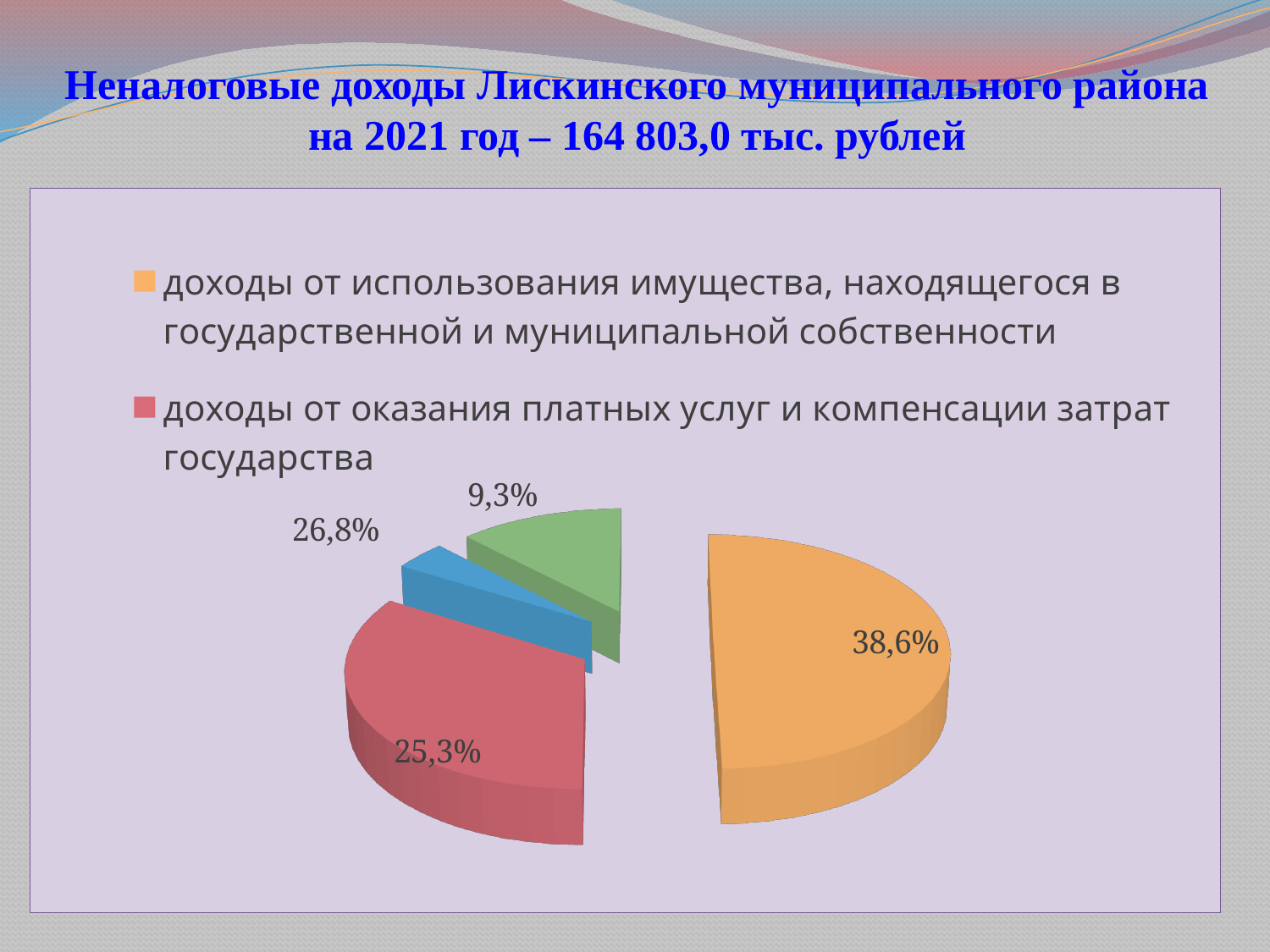
What is the difference in percentage points between the 38,6% slice and the 25,3% slice? 13,3 What is the largest percentage shown on the pie chart? 38,6% What is the difference in percentage points between the 26,8% slice and the 25,3% slice? 1,5 What is the smallest percentage shown on the pie chart? 9,3% What share of the pie is labelled for 'доходы от оказания платных услуг и компенсации затрат государства'? 25,3% What kind of chart is shown on the slide? pie chart What colour is the slice labelled 9,3%? green Which is larger: the slice for 'доходы от использования имущества' or the slice for 'доходы от оказания платных услуг'? доходы от использования имущества What share of the pie is labelled for 'доходы от использования имущества, находящегося в государственной и муниципальной собственности'? 38,6% How many slices does the pie chart have? 4 What total amount of non-tax revenue for 2021 is stated in the slide title? 164 803,0 тыс. рублей How many entries does the legend list? 2